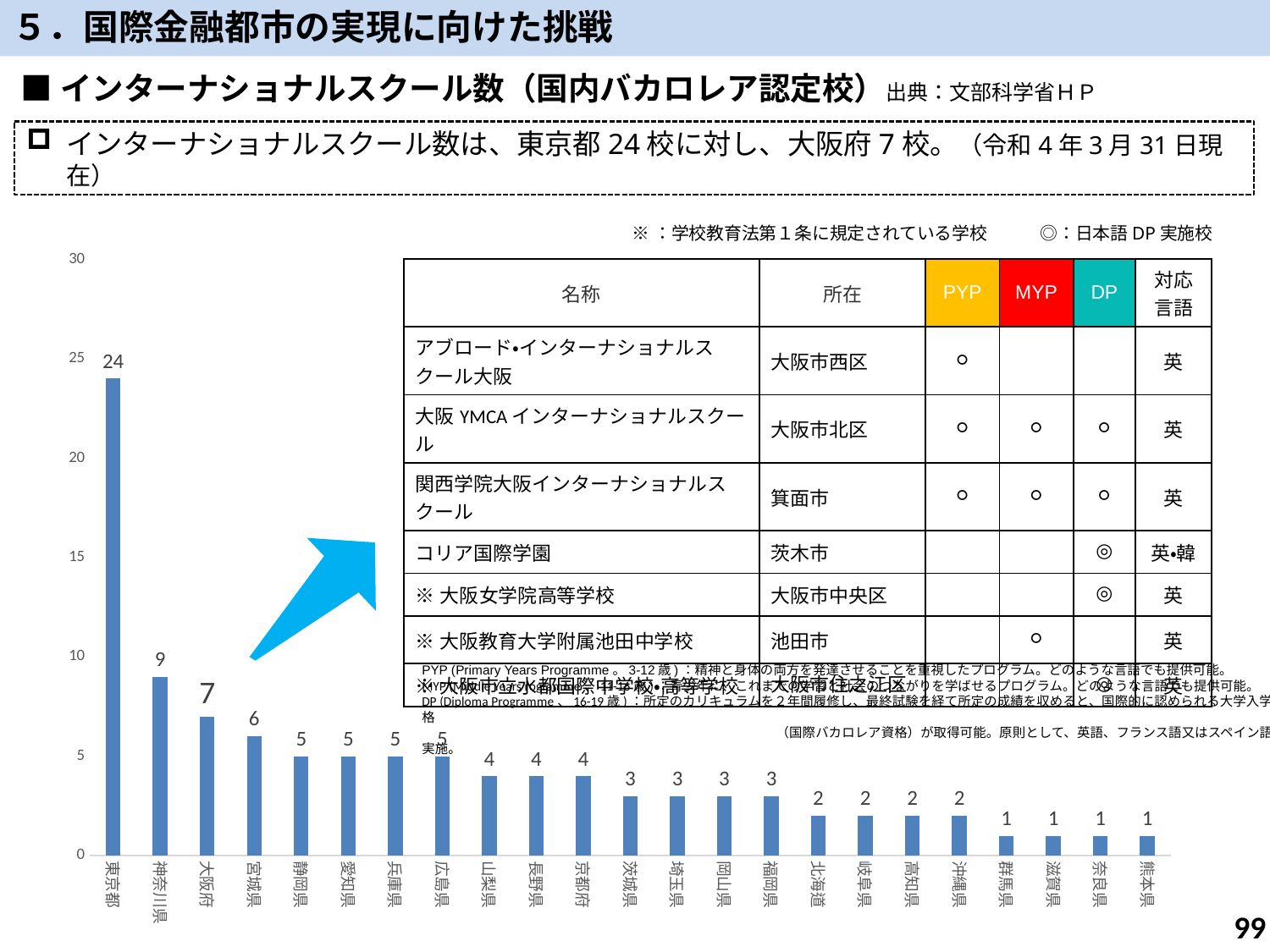
What is the difference between the values for 東京都 and 大阪府? 17 What kind of chart is shown on the slide? bar chart How many categories are shown on the x axis of the bar chart? 23 What is the value for 宮城県 in the bar chart? 6 What is the value for 東京都 in the bar chart? 24 Which is larger, the value for 兵庫県 or the value for 京都府? 兵庫県 Do the values rise or fall moving from left to right along the x axis? fall What is the difference between the values for 神奈川県 and 大阪府? 2 Which category has the highest value in the bar chart? 東京都 What is the value for 大阪府 in the bar chart? 7 Is the value for 東京都 greater or less than 20? greater What is the value for 神奈川県 in the bar chart? 9